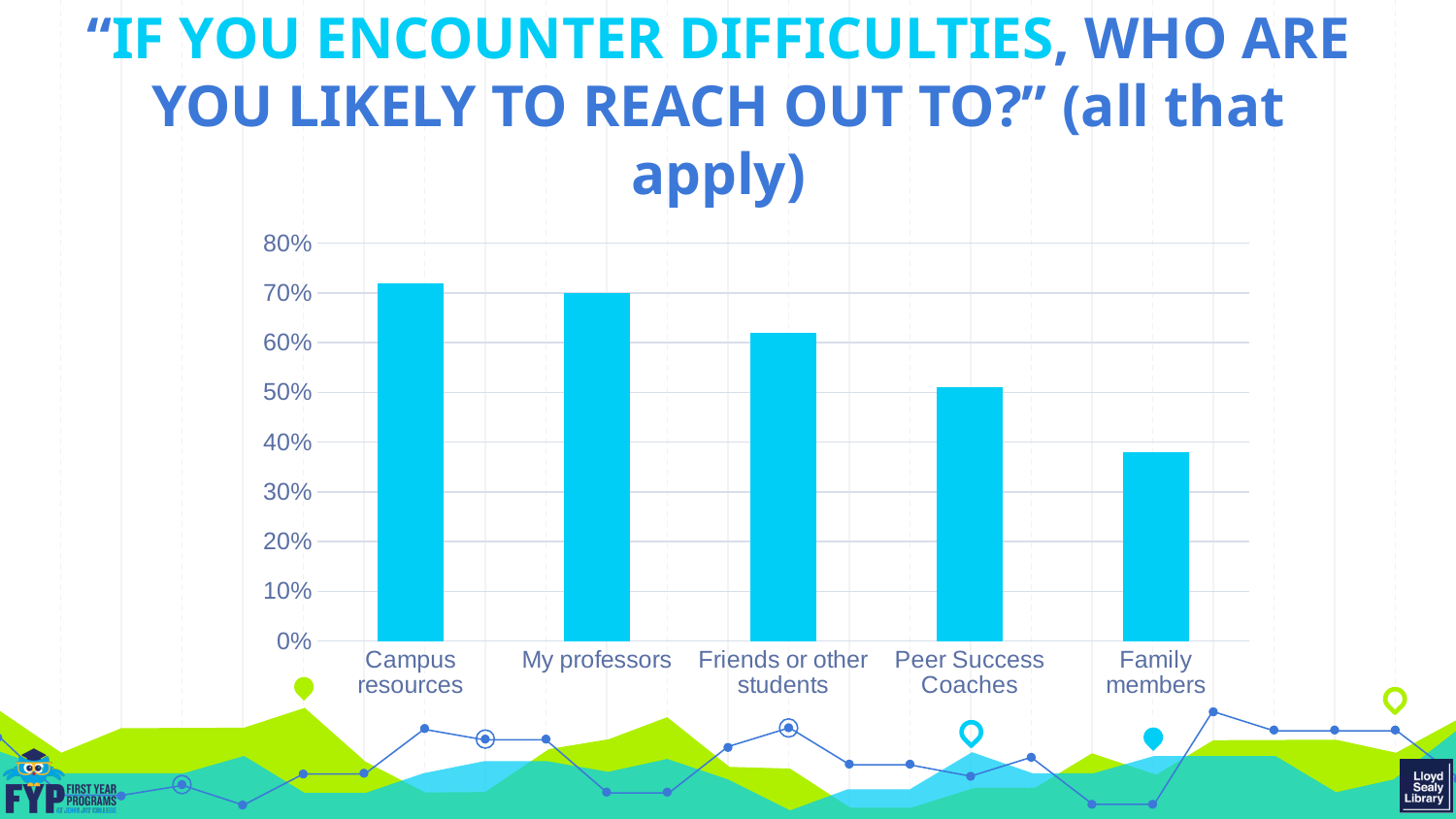
Which is larger, the value for Peer Success Coaches or the value for Family members? Peer Success Coaches Is the value for Friends or other students greater or less than 50%? greater Which category has the lowest value in the chart? Family members Do the bar values rise or fall from left to right across the x axis? fall Is the value for Campus resources greater or less than 60%? greater What kind of chart is shown on the slide? bar chart Which is larger, the value for Campus resources or the value for Friends or other students? Campus resources Is the value for Family members greater or less than 30%? greater How many categories are shown on the x axis of the chart? 5